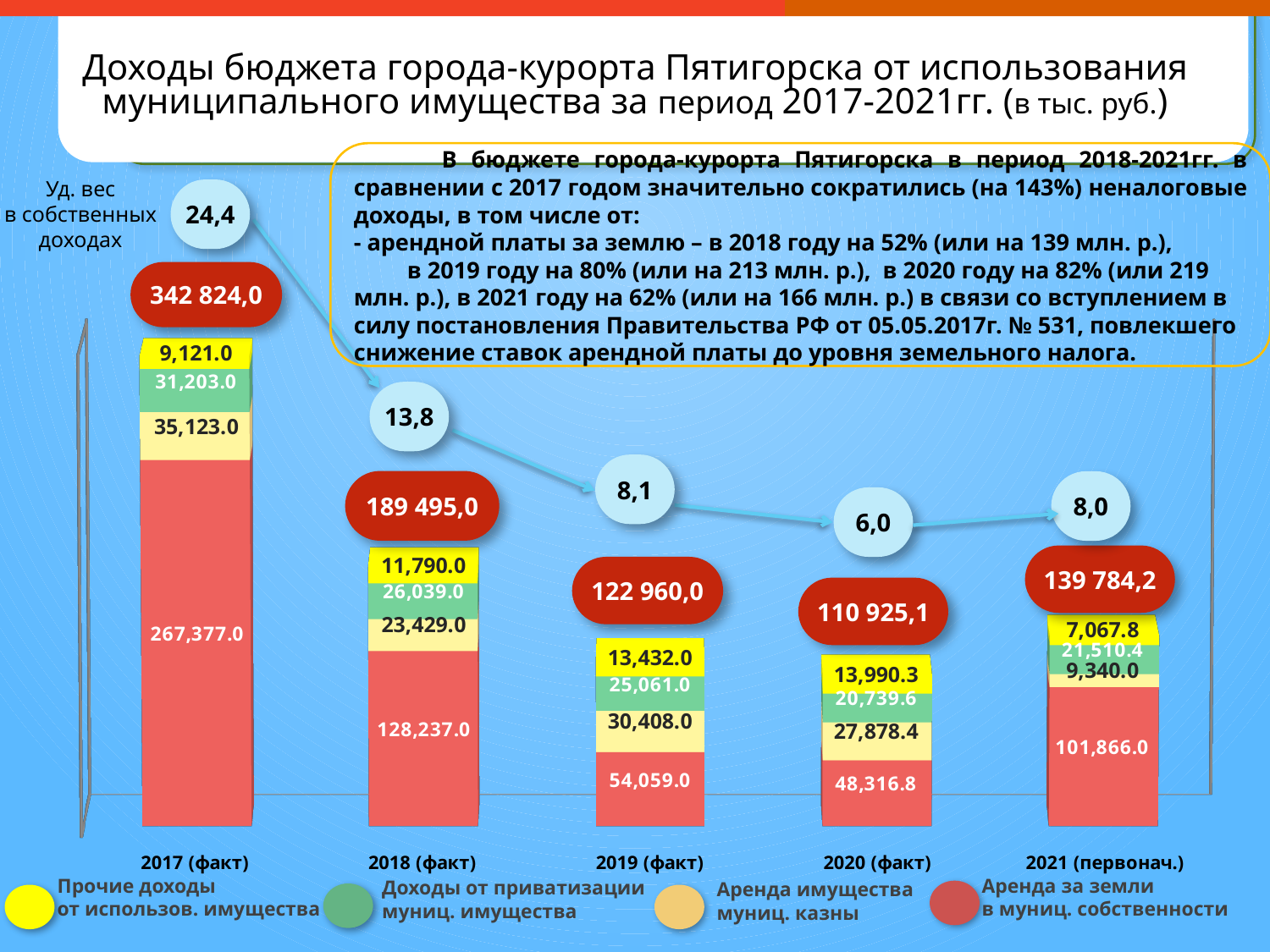
What is the value of 'Прочие доходы от использов. имущества' for 2020 (факт)? 13,990.3 What is the value of 'Доходы от приватизации муниц. имущества' for 2021 (первонач.)? 21,510.4 How many year categories are plotted on the chart? 5 Which is larger: 'Аренда за земли в муниц. собственности' in 2019 (факт) or in 2020 (факт)? 2019 (факт) What type of chart is shown on the slide? stacked bar chart What is the difference between 'Аренда имущества муниц. казны' in 2019 (факт) and 2018 (факт)? 6,979.0 What is the total shown for the 2019 (факт) bar? 122 960,0 Which year has the highest total income from municipal property? 2017 (факт) What is the value of 'Аренда за земли в муниц. собственности' for 2017 (факт)? 267,377.0 How many series does the legend list? 4 Which year has the lowest total income from municipal property? 2020 (факт) What is the share in own revenues (Уд. вес в собственных доходах) shown for 2018 (факт)? 13,8